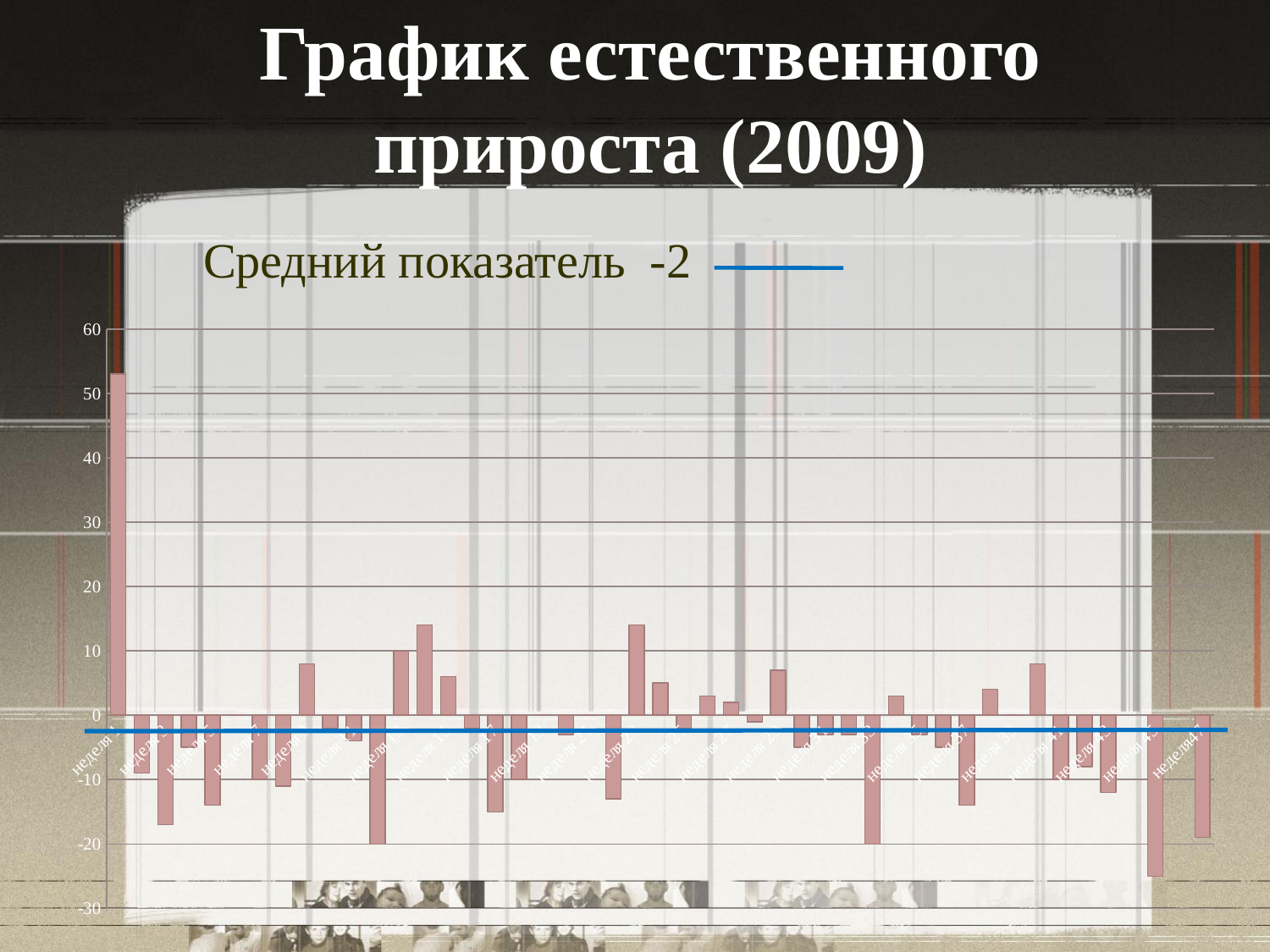
Is the value of the first bar (неделя 1) greater or less than 50? greater What is the title of the chart? График естественного прироста (2009) What kind of chart is shown on the slide? bar chart Which bar has the highest value? the first bar (неделя 1) What is the lowest value shown on the vertical axis? -30 Is the lowest bar on the chart greater or less than -20? less What is the highest value shown on the vertical axis? 60 Is the value of the first bar greater or less than the value of the last bar? greater What average value (Средний показатель) is stated on the slide? -2